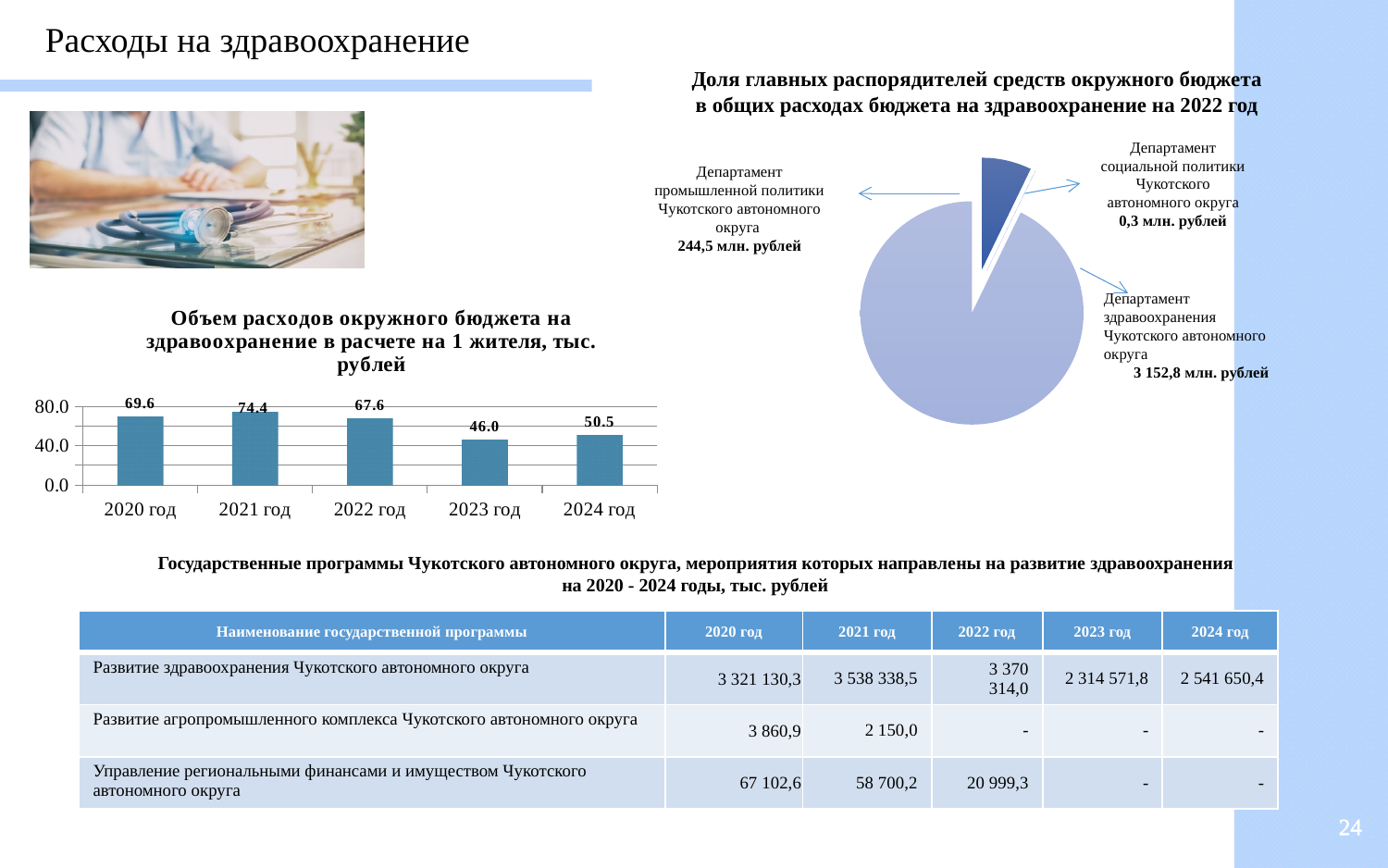
In the bar chart 'Объем расходов окружного бюджета на здравоохранение в расчете на 1 жителя, тыс. рублей', how many years are shown? 5 In the bar chart 'Объем расходов окружного бюджета на здравоохранение в расчете на 1 жителя, тыс. рублей', what is the value for 2023 год? 46.0 In the bar chart 'Объем расходов окружного бюджета на здравоохранение в расчете на 1 жителя, тыс. рублей', what is the difference between the values for 2020 год and 2024 год? 19.1 In the bar chart 'Объем расходов окружного бюджета на здравоохранение в расчете на 1 жителя, тыс. рублей', which is larger: the value for 2022 год or 2024 год? 2022 год What kind of chart is 'Объем расходов окружного бюджета на здравоохранение в расчете на 1 жителя, тыс. рублей'? bar chart In the bar chart 'Объем расходов окружного бюджета на здравоохранение в расчете на 1 жителя, тыс. рублей', which year has the lowest value? 2023 год In the pie chart 'Доля главных распорядителей средств окружного бюджета в общих расходах бюджета на здравоохранение на 2022 год', what is the value for Департамент промышленной политики Чукотского автономного округа? 244,5 млн. рублей In the pie chart 'Доля главных распорядителей средств окружного бюджета в общих расходах бюджета на здравоохранение на 2022 год', what is the value for Департамент здравоохранения Чукотского автономного округа? 3 152,8 млн. рублей In the pie chart 'Доля главных распорядителей средств окружного бюджета в общих расходах бюджета на здравоохранение на 2022 год', which department has the smallest slice? Департамент социальной политики Чукотского автономного округа In the bar chart 'Объем расходов окружного бюджета на здравоохранение в расчете на 1 жителя, тыс. рублей', do the values rise or fall from 2022 год to 2023 год? fall In the bar chart 'Объем расходов окружного бюджета на здравоохранение в расчете на 1 жителя, тыс. рублей', what is the value for 2021 год? 74.4 In the bar chart 'Объем расходов окружного бюджета на здравоохранение в расчете на 1 жителя, тыс. рублей', which year has the highest value? 2021 год